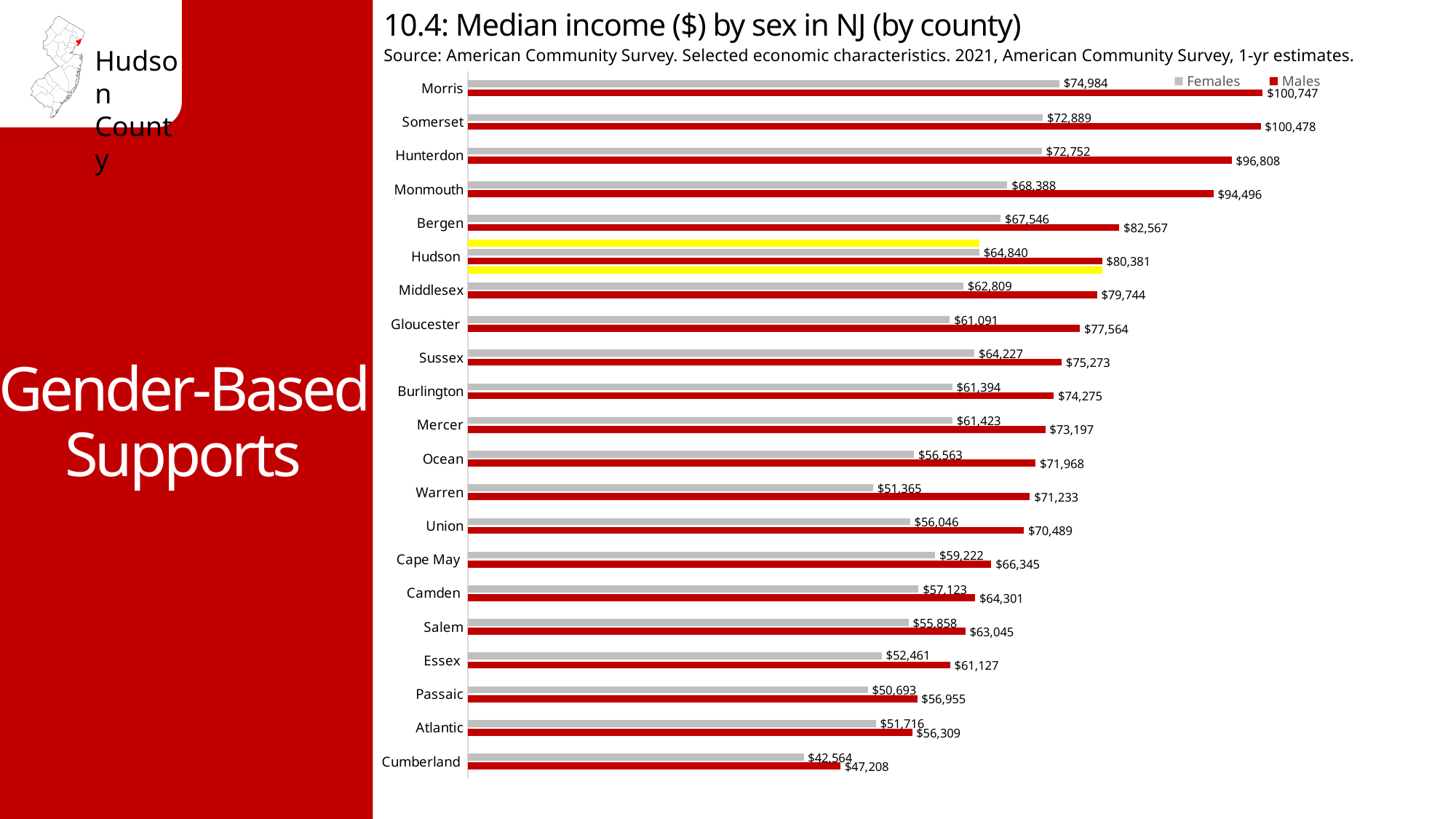
Which is larger, the female median income in Sussex County or in Middlesex County? Sussex What is the difference between male and female median income in Hudson County? $15,541 How many series does the legend list? 2 What is the median income for females in Morris County? $74,984 Which county has the lowest median income for females? Cumberland What is the median income for males in Cumberland County? $47,208 How many counties are shown in the chart? 21 What is the difference between male and female median income in Morris County? $25,763 Which county has the highest median income for males? Morris What kind of chart is shown on the slide? Bar chart What is the median income for females in Hudson County? $64,840 What is the median income for males in Hudson County? $80,381